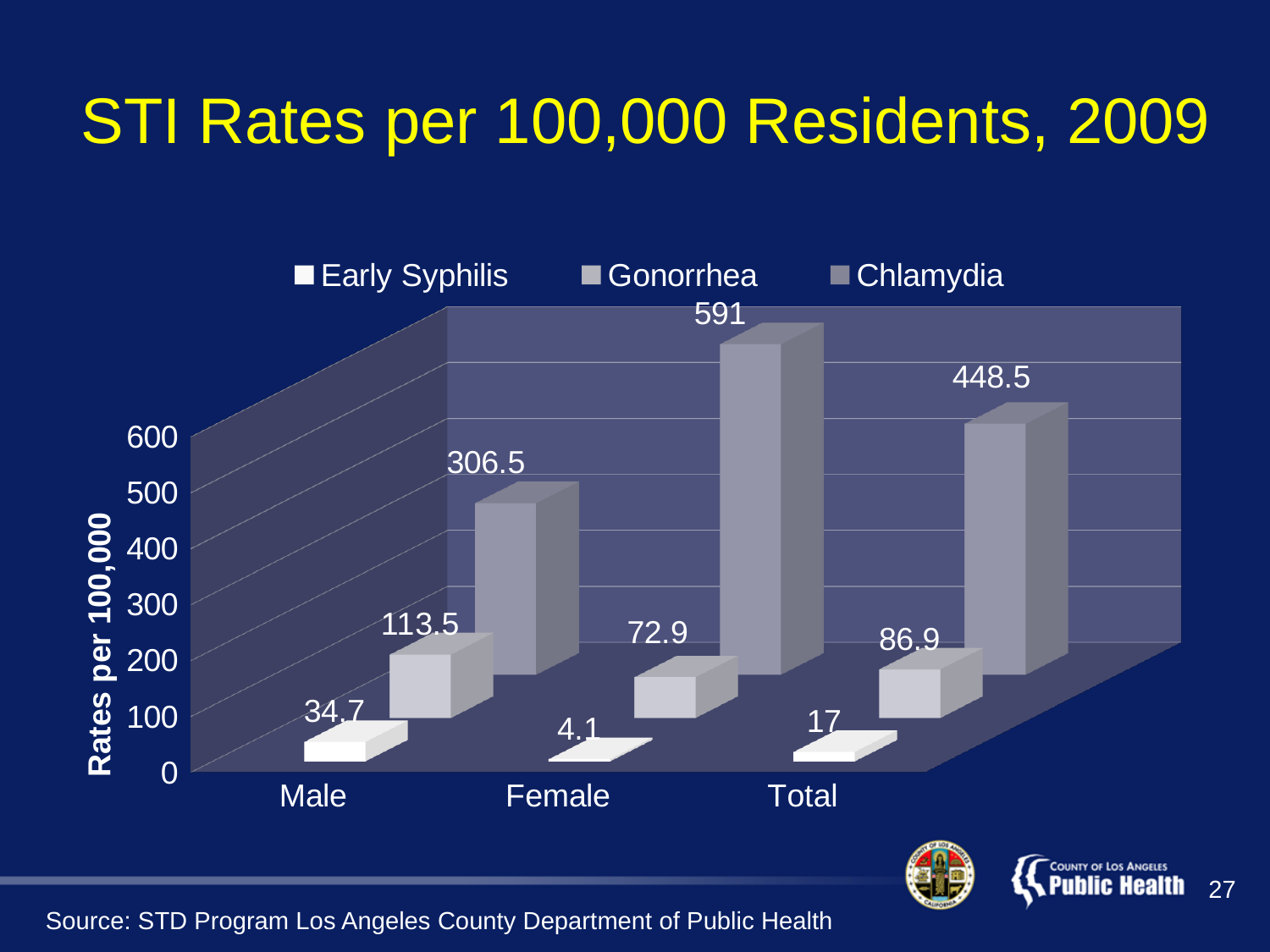
What is the Chlamydia rate for Female? 591 What is the difference between the Chlamydia rate for Female and the Chlamydia rate for Male? 284.5 How many categories are shown on the x axis? 3 What is the label of the vertical axis? Rates per 100,000 Which category has the highest Chlamydia rate? Female What is the Gonorrhea rate for Male? 113.5 How many series does the legend list? 3 Which is larger, the Gonorrhea rate for Male or the Gonorrhea rate for Female? Male What is the Early Syphilis rate for Total? 17 What is the title of the chart? STI Rates per 100,000 Residents, 2009 What kind of chart is shown on the slide? Bar chart Which category has the lowest Early Syphilis rate? Female